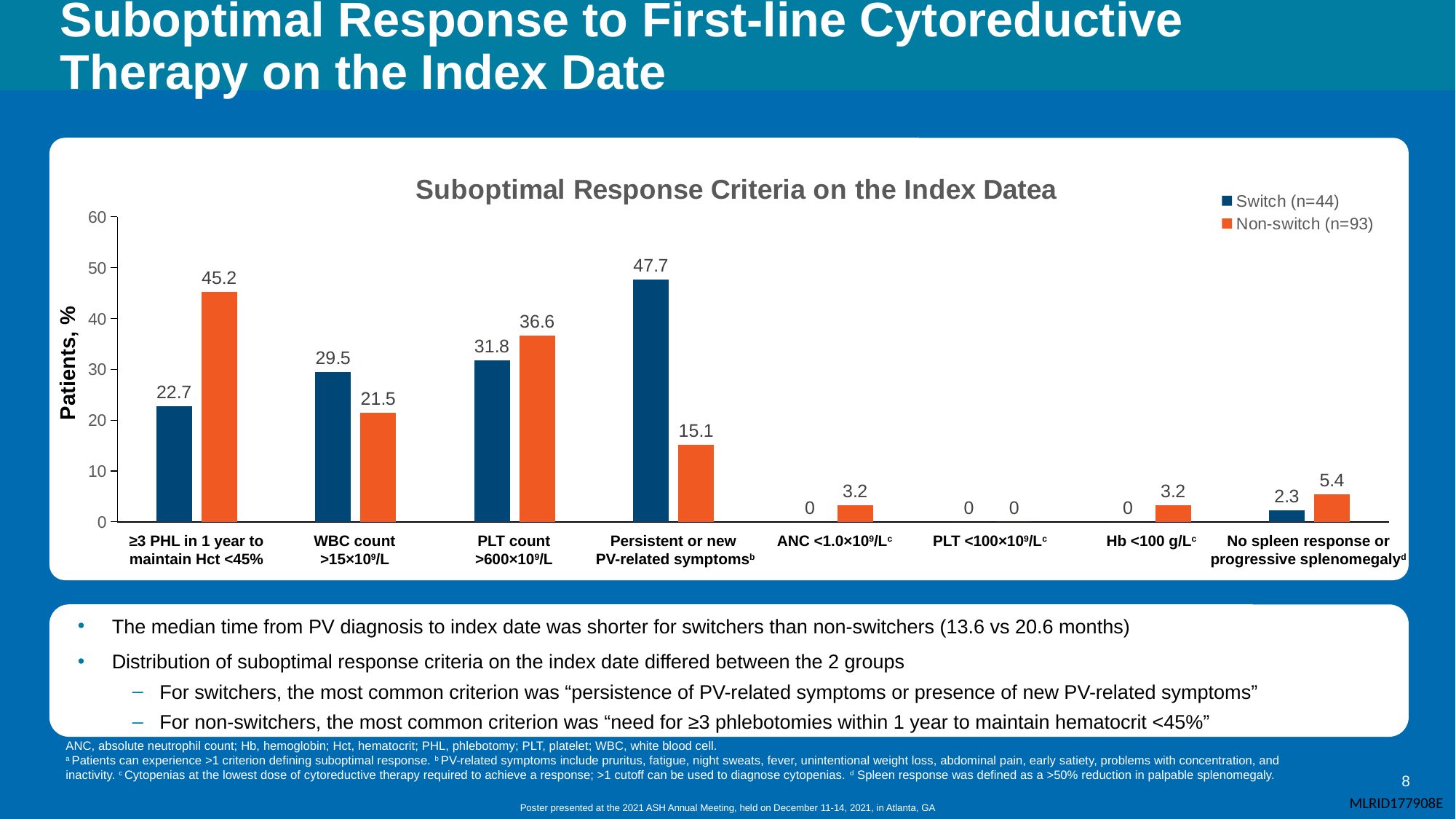
What is the Non-switch value for ≥3 PHL in 1 year to maintain Hct <45%? 45.2 What is the Switch value for WBC count >15×10⁹/L? 29.5 What is the Non-switch value for No spleen response or progressive splenomegaly? 5.4 What is the difference between the Switch and Non-switch values for persistent or new PV-related symptoms? 32.6 What percentage of Switch patients had persistent or new PV-related symptoms? 47.7 Which criterion has the highest value for the Non-switch group? ≥3 PHL in 1 year to maintain Hct <45% What kind of chart is shown on the slide? Bar chart For PLT count >600×10⁹/L, which group has the larger value, Switch or Non-switch? Non-switch Which criterion has the highest value for the Switch group? Persistent or new PV-related symptoms How many series does the legend list? 2 How many suboptimal response criteria are shown on the x axis? 8 What is the sample size of the Non-switch group shown in the legend? n=93